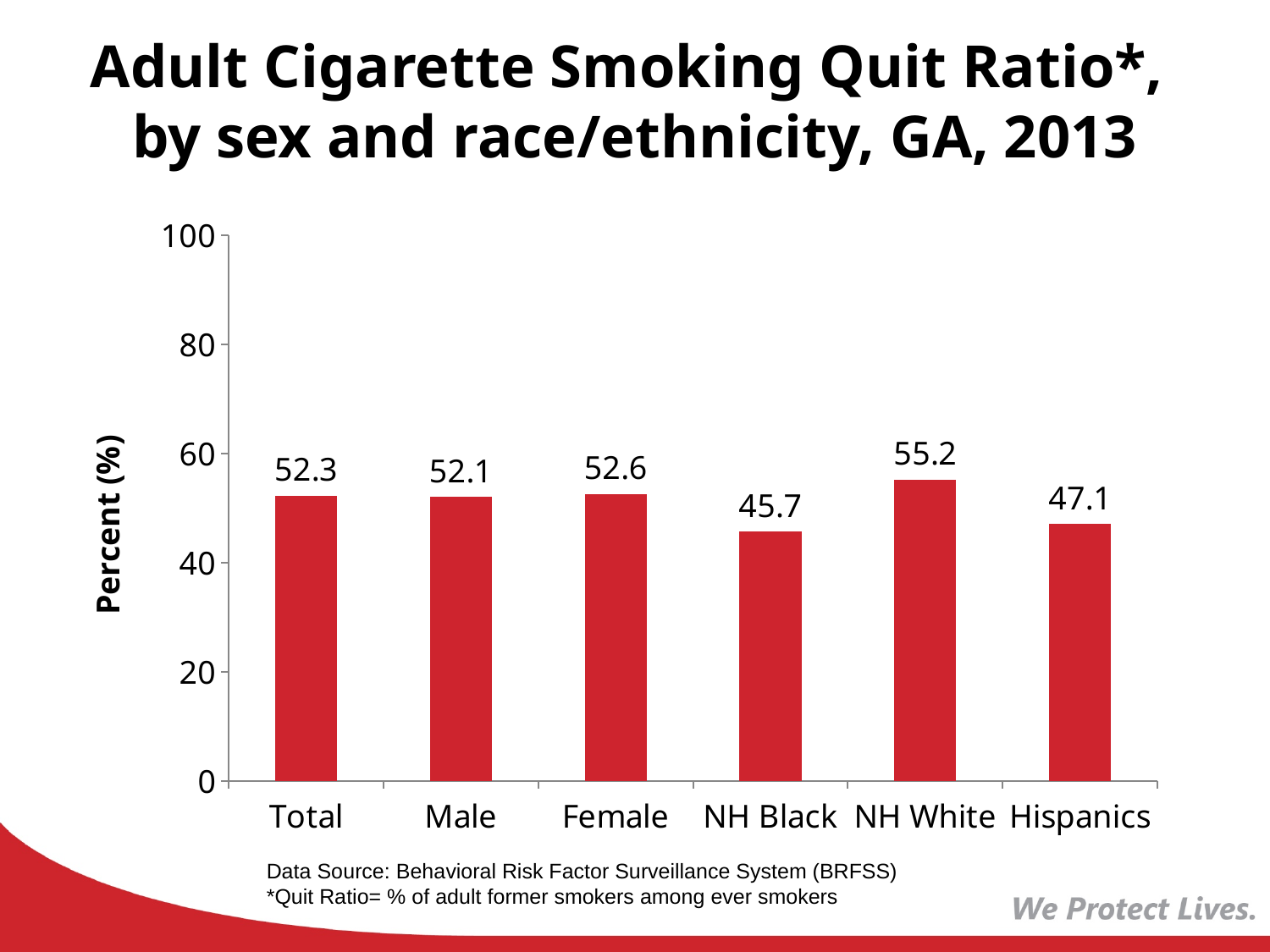
What is the quit ratio for NH Black? 45.7 What is the difference between the quit ratio for NH White and NH Black? 9.5 Which category has the highest quit ratio? NH White Which category has the lowest quit ratio? NH Black What is the label of the y axis? Percent (%) What kind of chart is shown on the slide? bar chart What is the quit ratio for Female? 52.6 What is the quit ratio for Hispanics? 47.1 Which has a higher quit ratio, Hispanics or NH White? NH White What is the difference between the quit ratio for Female and Male? 0.5 Is the value for Total greater or less than 40? greater How many categories are shown on the x axis? 6